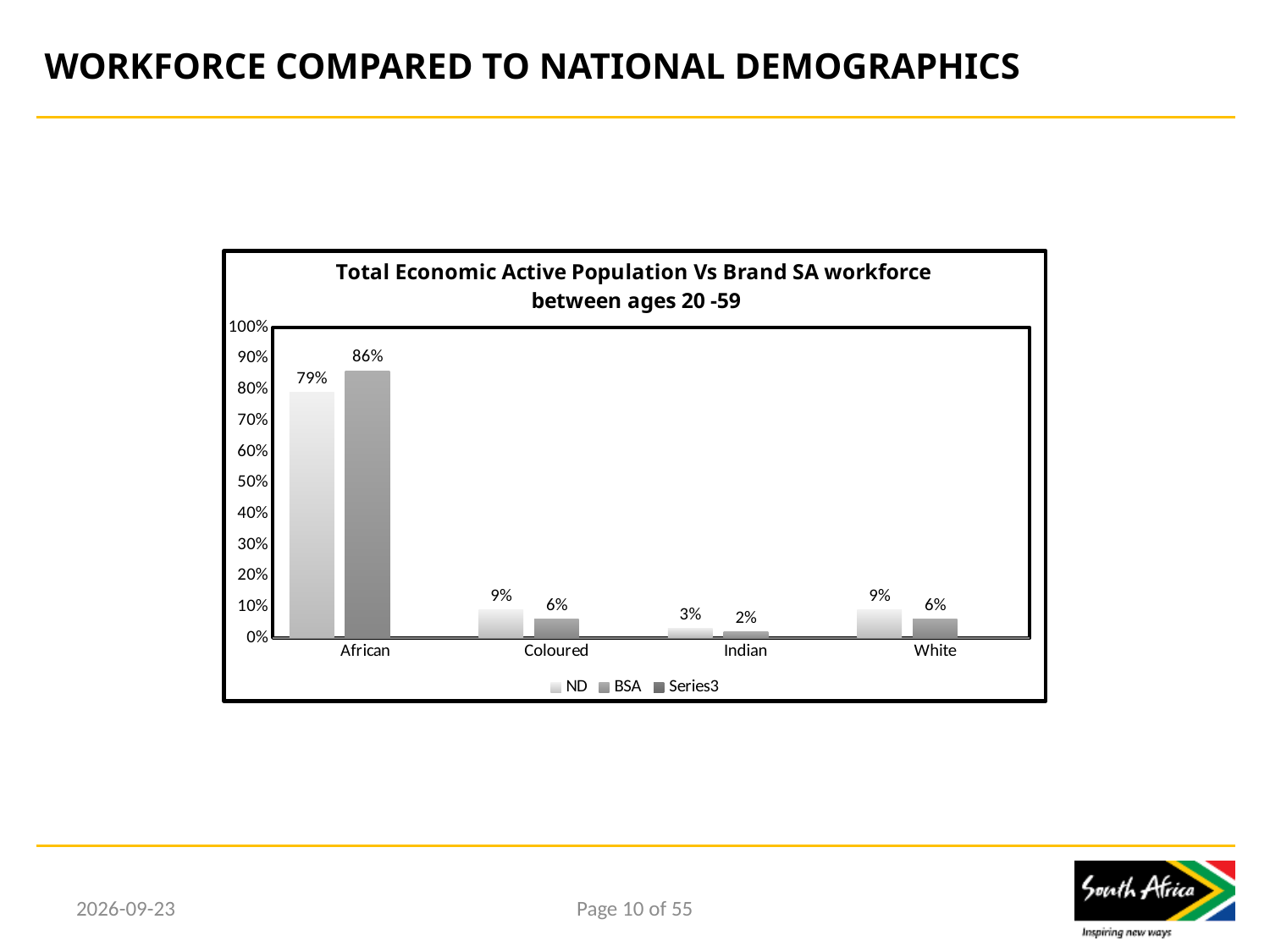
What is the BSA value for Coloured? 6% What kind of chart is shown on the slide? Bar chart What is the ND value for African? 79% What is the ND value for Indian? 3% How many series does the legend list? 3 Which category has the highest BSA value? African Which is larger for White, the ND value or the BSA value? ND What is the difference between the BSA and ND values for African? 7% Is the BSA value for African greater or less than 80%? greater How many categories are shown on the x axis? 4 Which category has the lowest ND value? Indian What is the BSA value for African? 86%